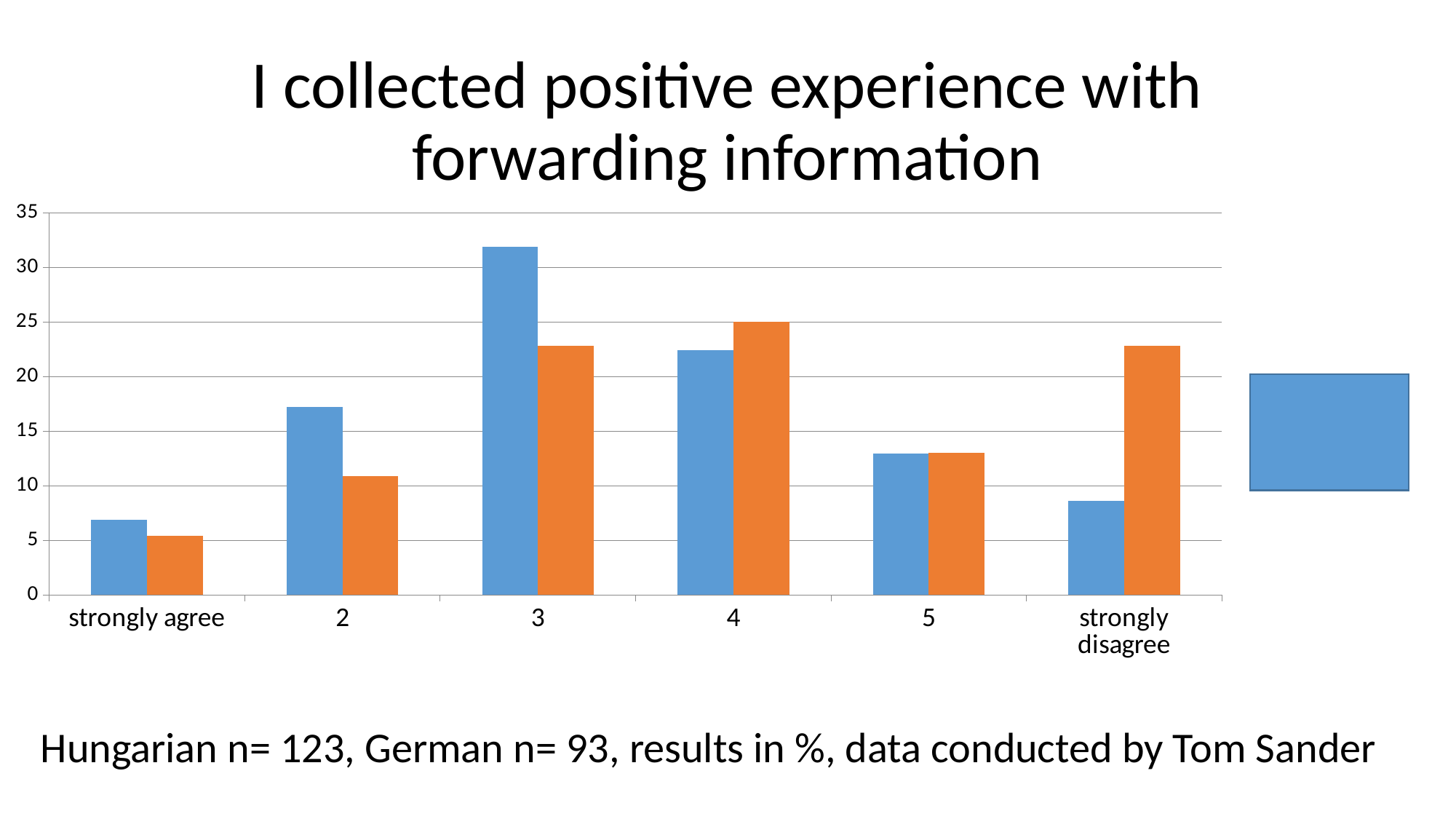
For which category is the blue bar the lowest? strongly agree What kind of chart is shown on the slide? bar chart For the strongly disagree category, which bar is taller, the blue or the orange one? orange What is the title of the chart? I collected positive experience with forwarding information For which category is the orange bar the highest? 4 How many categories are shown along the x axis? 6 For category 2, which bar is taller, the blue or the orange one? blue Is the orange bar for strongly disagree greater or less than 20? greater Is the blue bar for category 3 greater or less than 30? greater Is the orange bar for category 2 greater or less than 15? less For which category is the blue bar the highest? 3 For which category is the orange bar the lowest? strongly agree